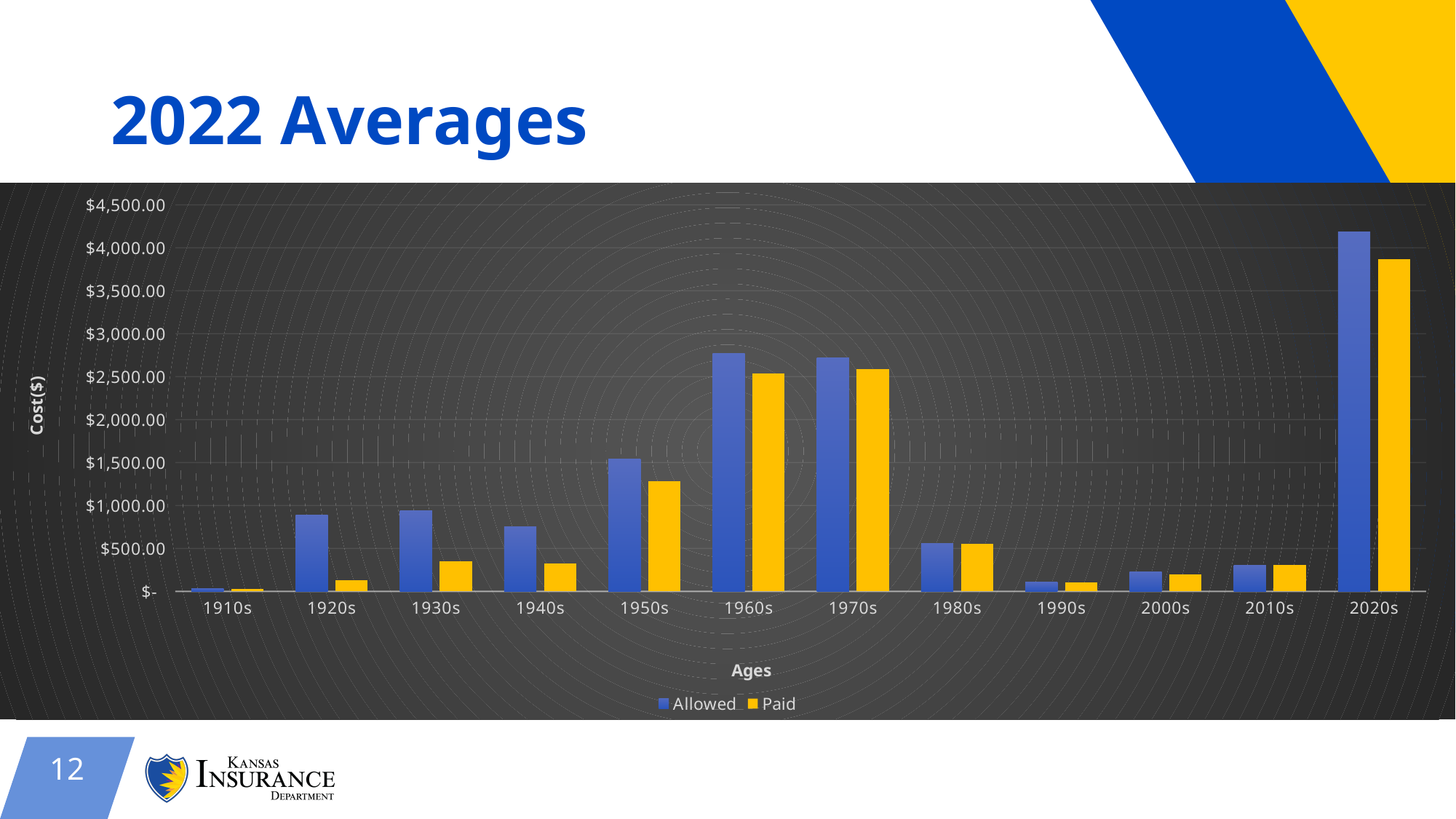
How many series does the legend list? 2 For the 1950s, which is larger, the Allowed value or the Paid value? Allowed Which age category has the lowest Allowed value? 1910s Which is larger, the Allowed value for the 1960s or the Allowed value for the 1980s? 1960s Is the Paid value for the 1950s greater or less than $1,000.00? greater What kind of chart is shown on the slide? bar chart Is the Allowed value for the 1960s greater or less than $2,500.00? greater What is the label of the y axis? Cost($) How many age categories are shown on the x axis? 12 Is the Paid value for the 1920s greater or less than $500.00? less Which age category has the highest Allowed value? 2020s